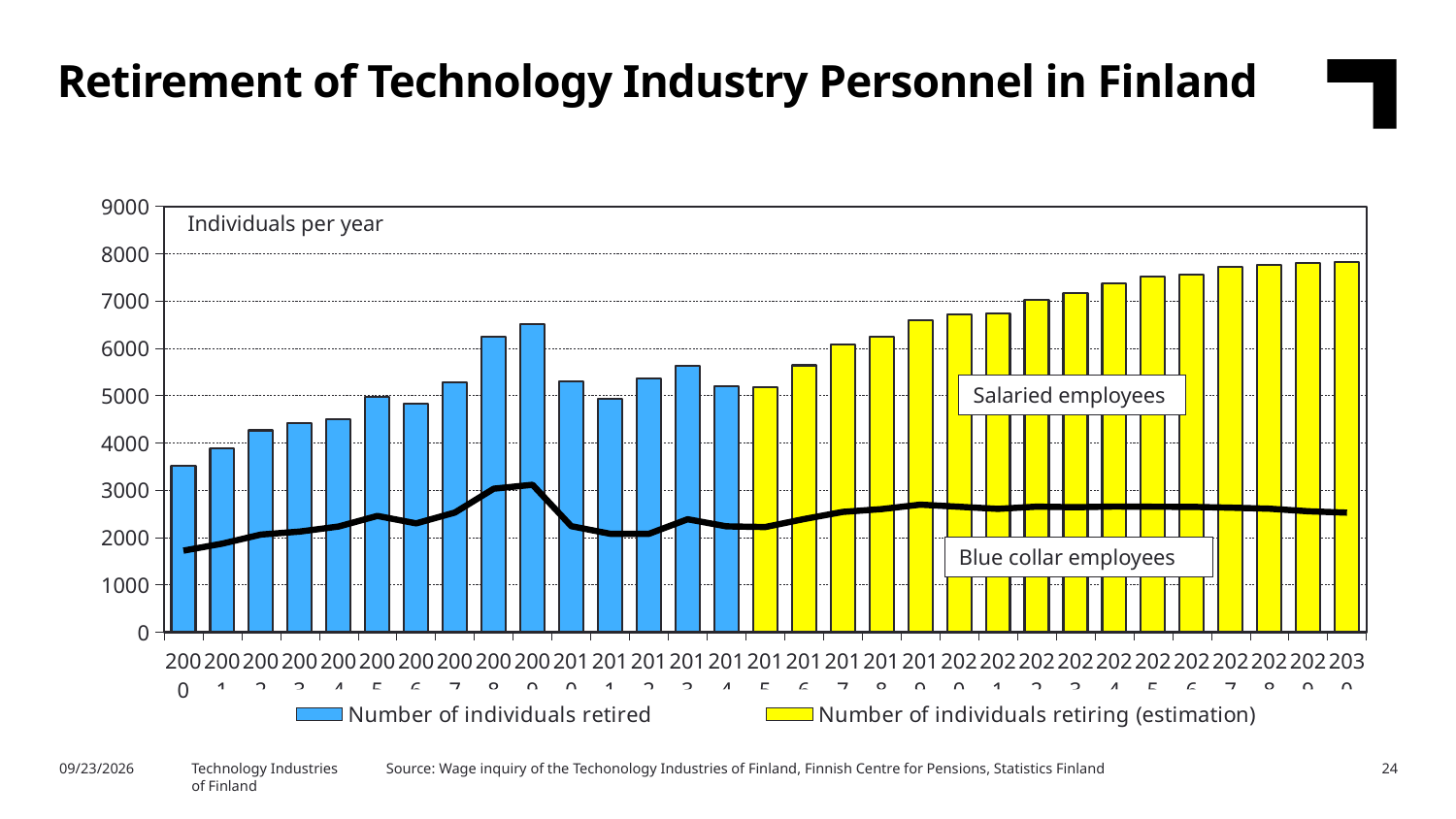
How many entries does the legend list? 2 Is the value for 2030 greater or less than 8000? less Is the value for 2009 greater or less than 6000? greater Which year has the lowest bar? 2000 What kind of chart is shown on the slide? combination bar and line chart Is the value for 2000 greater or less than 3000? greater Do the estimated values (yellow bars) rise or fall from 2015 to 2030? rise Which legend entry is shown in yellow? Number of individuals retiring (estimation) What is the title of the slide? Retirement of Technology Industry Personnel in Finland How many years (bars) are plotted along the x axis? 31 Which is larger, the value for 2009 or the value for 2010? 2009